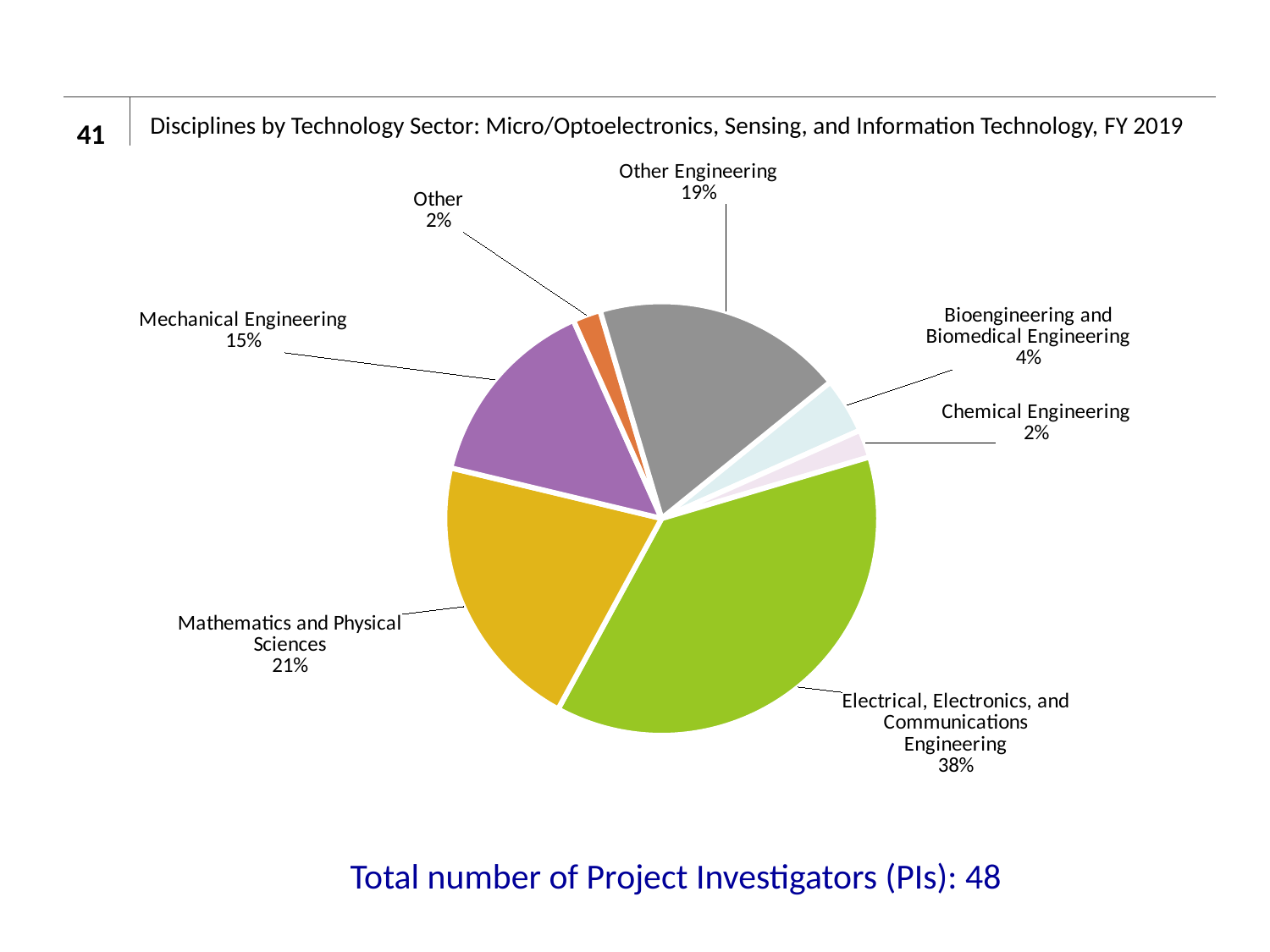
What kind of chart is shown on the slide? Pie chart What percentage is shown for Mechanical Engineering? 15% What share of the pie does Electrical, Electronics, and Communications Engineering hold? 38% What percentage is shown for Mathematics and Physical Sciences? 21% What percentage is shown for Bioengineering and Biomedical Engineering? 4% What is the difference in percentage points between Mathematics and Physical Sciences and Mechanical Engineering? 6 Which is larger, the share for Other Engineering or the share for Mechanical Engineering? Other Engineering How many slices does the pie chart have? 7 What is the title of the chart? Disciplines by Technology Sector: Micro/Optoelectronics, Sensing, and Information Technology, FY 2019 What is the total number of Project Investigators (PIs) stated on the slide? 48 What percentage is shown for Other Engineering? 19% Which discipline has the largest slice of the pie? Electrical, Electronics, and Communications Engineering